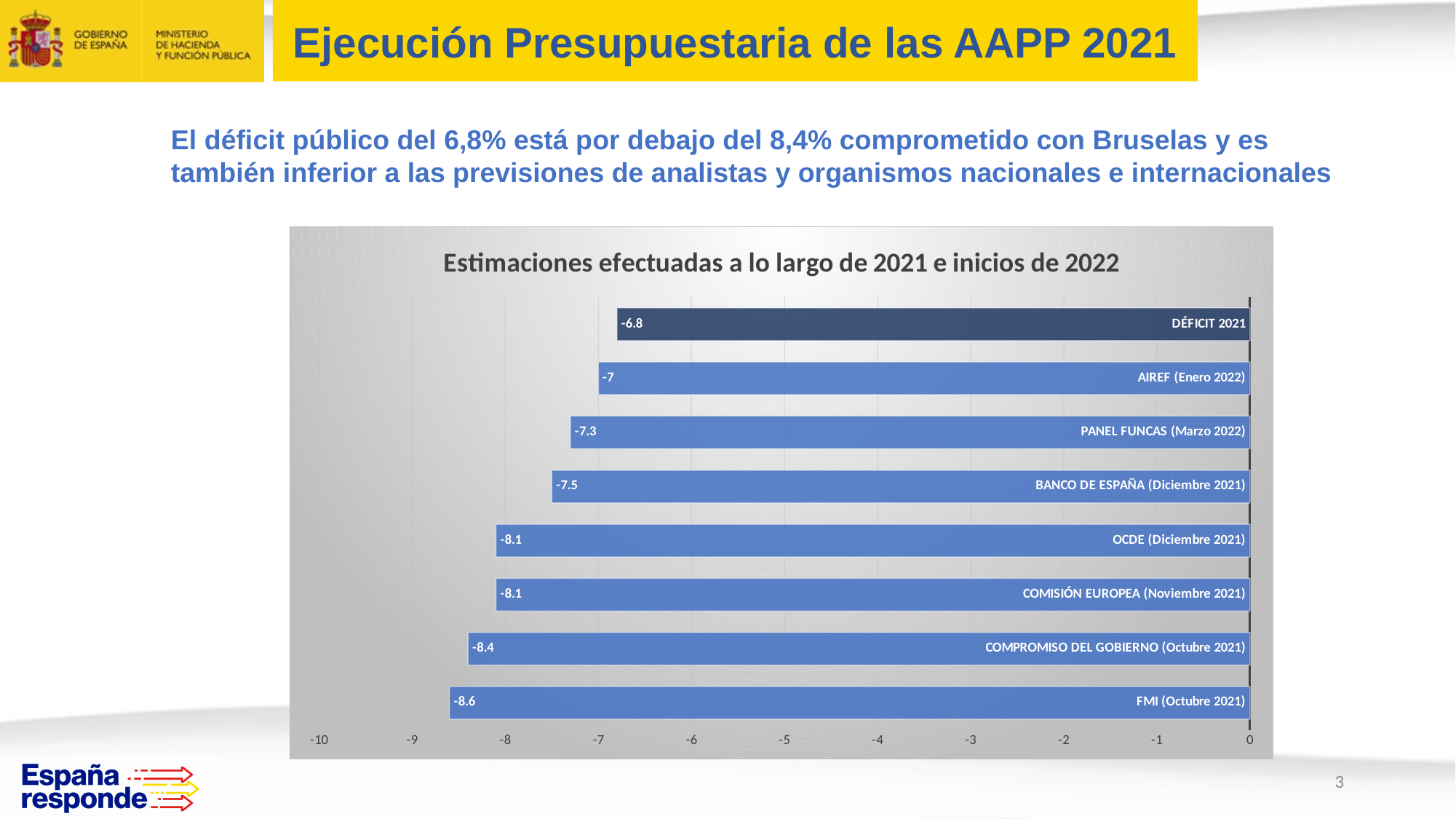
What is the title of the chart? Estimaciones efectuadas a lo largo de 2021 e inicios de 2022 What type of chart is shown on the slide? Bar chart Which category has the highest (least negative) value in the chart? DÉFICIT 2021 What is the value for BANCO DE ESPAÑA (Diciembre 2021)? -7.5 How many categories (bars) are shown in the chart? 8 What is the value shown for DÉFICIT 2021? -6.8 What is the difference between the values for FMI (Octubre 2021) and DÉFICIT 2021? 1.8 Which has a more negative value, PANEL FUNCAS (Marzo 2022) or OCDE (Diciembre 2021)? OCDE (Diciembre 2021) What value is shown for FMI (Octubre 2021)? -8.6 Which category has the most negative (lowest) value in the chart? FMI (Octubre 2021) What is the difference between the values for COMPROMISO DEL GOBIERNO (Octubre 2021) and AIREF (Enero 2022)? 1.4 What value is shown for COMPROMISO DEL GOBIERNO (Octubre 2021)? -8.4